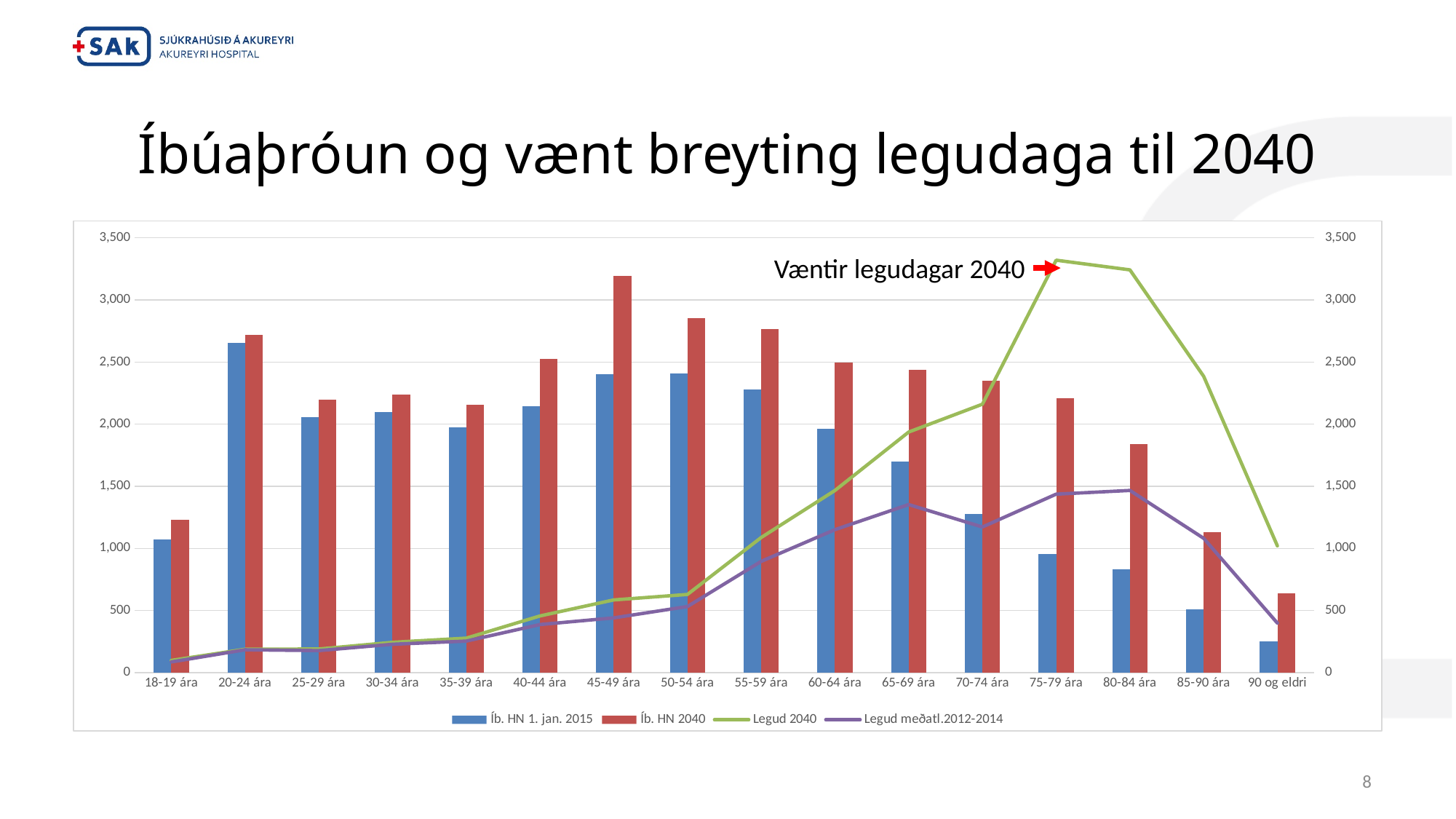
Which age category has the highest value for the Íb. HN 1. jan. 2015 series? 20-24 ára What kind of chart is shown on the slide? Combination bar and line chart For 60-64 ára, which is larger: Íb. HN 2040 or Íb. HN 1. jan. 2015? Íb. HN 2040 Which age category has the lowest value for the Íb. HN 1. jan. 2015 series? 90 og eldri Does the Legud 2040 line rise or fall from 18-19 ára to 75-79 ára? rise Is the Legud 2040 value for 90 og eldri greater or less than 1,500? less How many series does the chart legend list? 4 Is the Íb. HN 2040 value for 80-84 ára greater or less than 2,000? less Is the Íb. HN 2040 value for 45-49 ára greater or less than 3,000? greater What text does the red arrow annotation on the chart point to the green line with? Væntir legudagar 2040 How many age categories are shown on the x axis of the chart? 16 Which age category has the highest value for the Íb. HN 2040 series? 45-49 ára